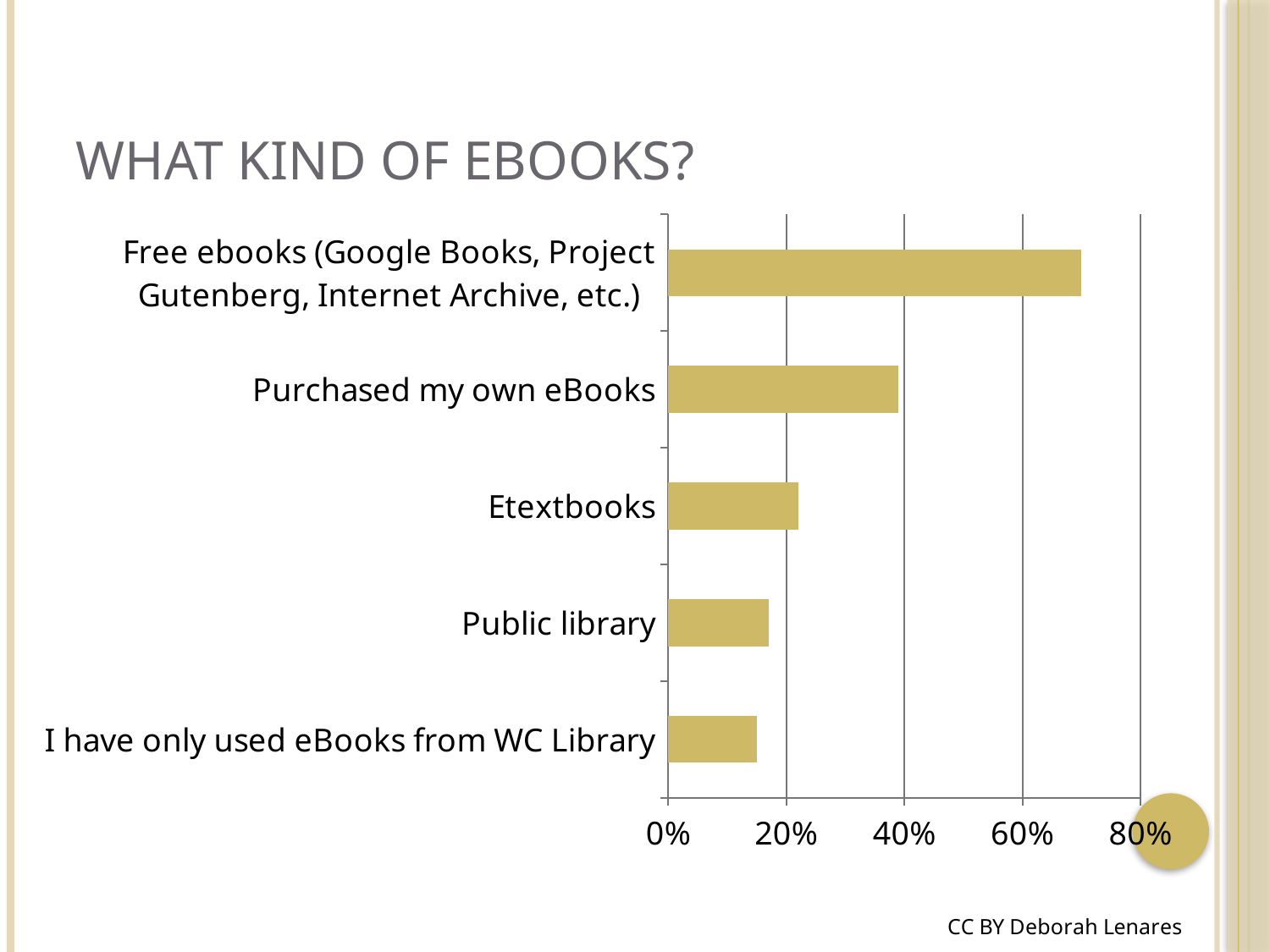
Which is larger, the value for Etextbooks or the value for Public library? Etextbooks Is the value for Purchased my own eBooks greater or less than 20%? greater Is the value for Etextbooks greater or less than 40%? less What is the title of the chart? WHAT KIND OF EBOOKS? Is the value for Public library greater or less than 20%? less Do the bar values increase or decrease going from the top category to the bottom category? decrease Which is larger, the value for Free ebooks (Google Books, Project Gutenberg, Internet Archive, etc.) or the value for Purchased my own eBooks? Free ebooks (Google Books, Project Gutenberg, Internet Archive, etc.) What kind of chart is shown on the slide? bar chart How many categories are shown in the chart? 5 Which category has the highest value? Free ebooks (Google Books, Project Gutenberg, Internet Archive, etc.)